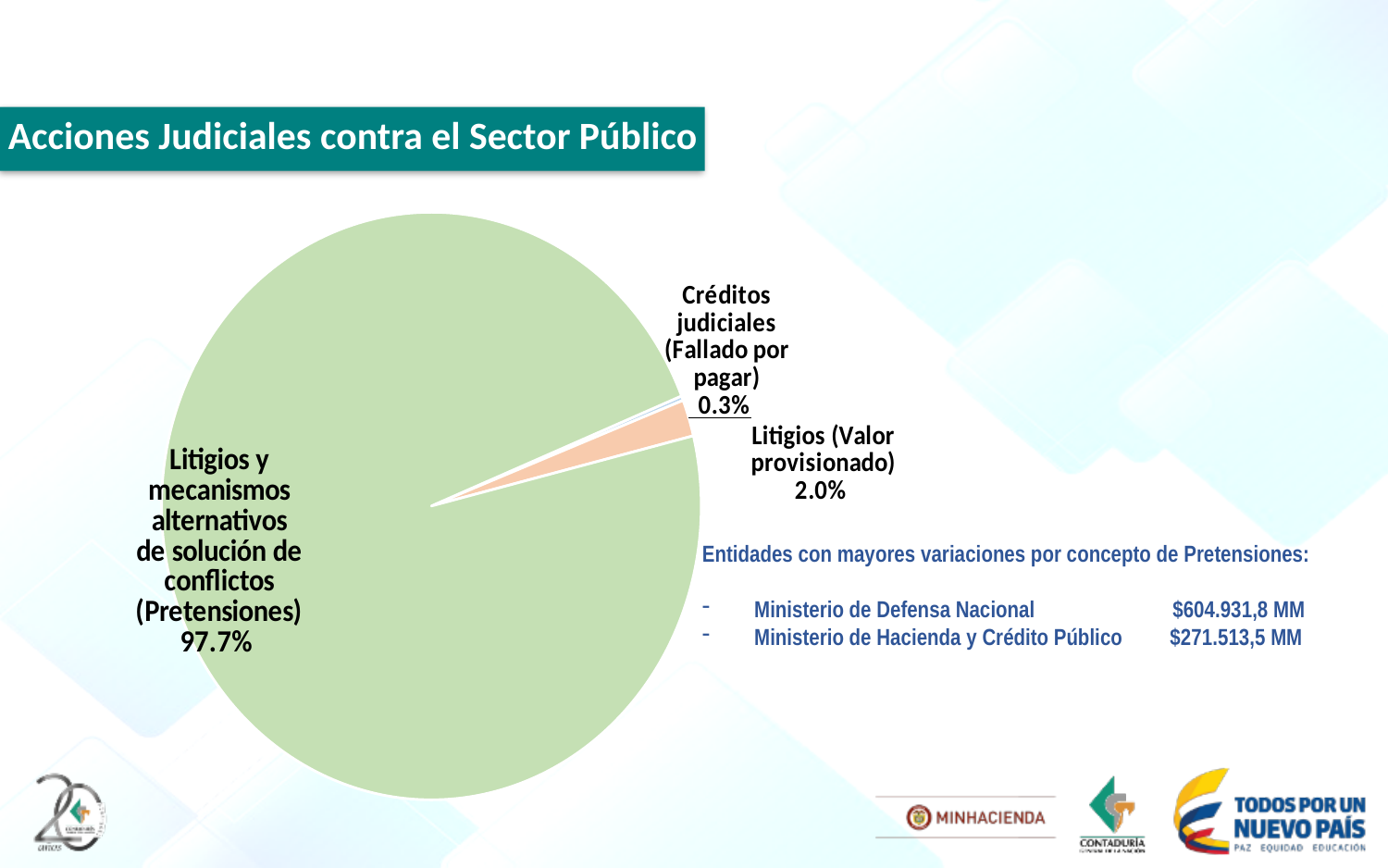
How many slices does the pie chart have? 3 Which slice of the pie chart is the smallest? Créditos judiciales (Fallado por pagar) What is the title shown in the header box of the slide? Acciones Judiciales contra el Sector Público What share of the pie does 'Litigios y mecanismos alternativos de solución de conflictos (Pretensiones)' represent? 97.7% What is the combined share of 'Litigios (Valor provisionado)' and 'Créditos judiciales (Fallado por pagar)'? 2.3% What colour is the largest slice of the pie chart? light green What share of the pie does 'Litigios (Valor provisionado)' represent? 2.0% What share of the pie does 'Créditos judiciales (Fallado por pagar)' represent? 0.3% What is the difference in percentage points between 'Litigios (Valor provisionado)' and 'Créditos judiciales (Fallado por pagar)'? 1.7 Which is larger: the share for 'Litigios (Valor provisionado)' or the share for 'Créditos judiciales (Fallado por pagar)'? Litigios (Valor provisionado) Which slice of the pie chart is the largest? Litigios y mecanismos alternativos de solución de conflictos (Pretensiones) What kind of chart is shown on the slide? pie chart